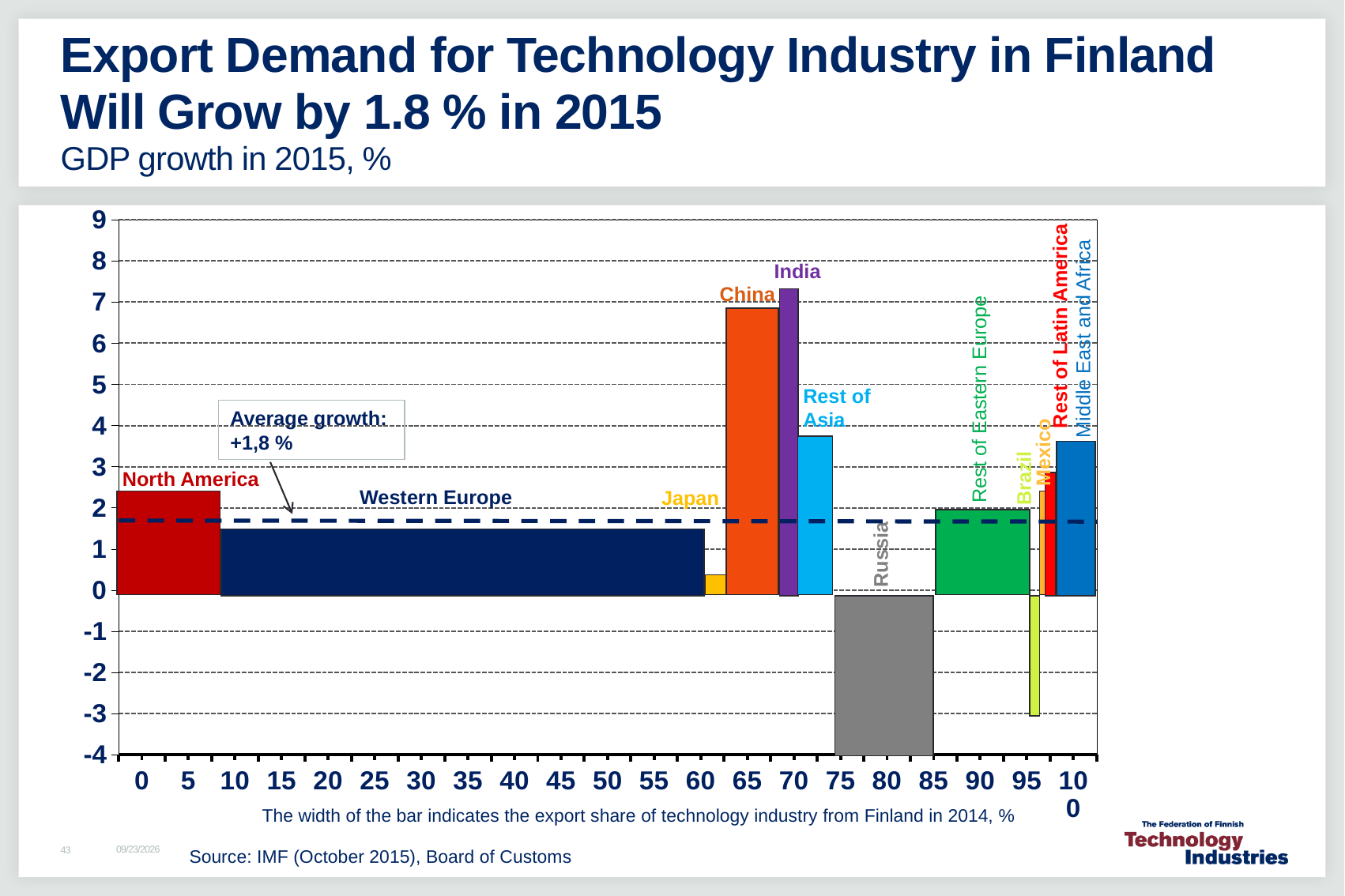
Which has the larger GDP growth, North America or Western Europe? North America What type of chart is shown on the slide? Bar chart Is the value for China greater or less than 5? greater Which has the larger GDP growth, China or Rest of Asia? China What average growth value is printed on the chart? +1,8 % Which country or region has the lowest GDP growth in 2015 in the chart? Russia Is the value for Western Europe greater or less than 2? less How many countries or regions are plotted as bars in the chart? 12 According to the note below the chart, what does the width of each bar indicate? The export share of technology industry from Finland in 2014, % Is the value for Japan greater or less than 1? less Which country or region has the highest GDP growth in 2015 in the chart? India